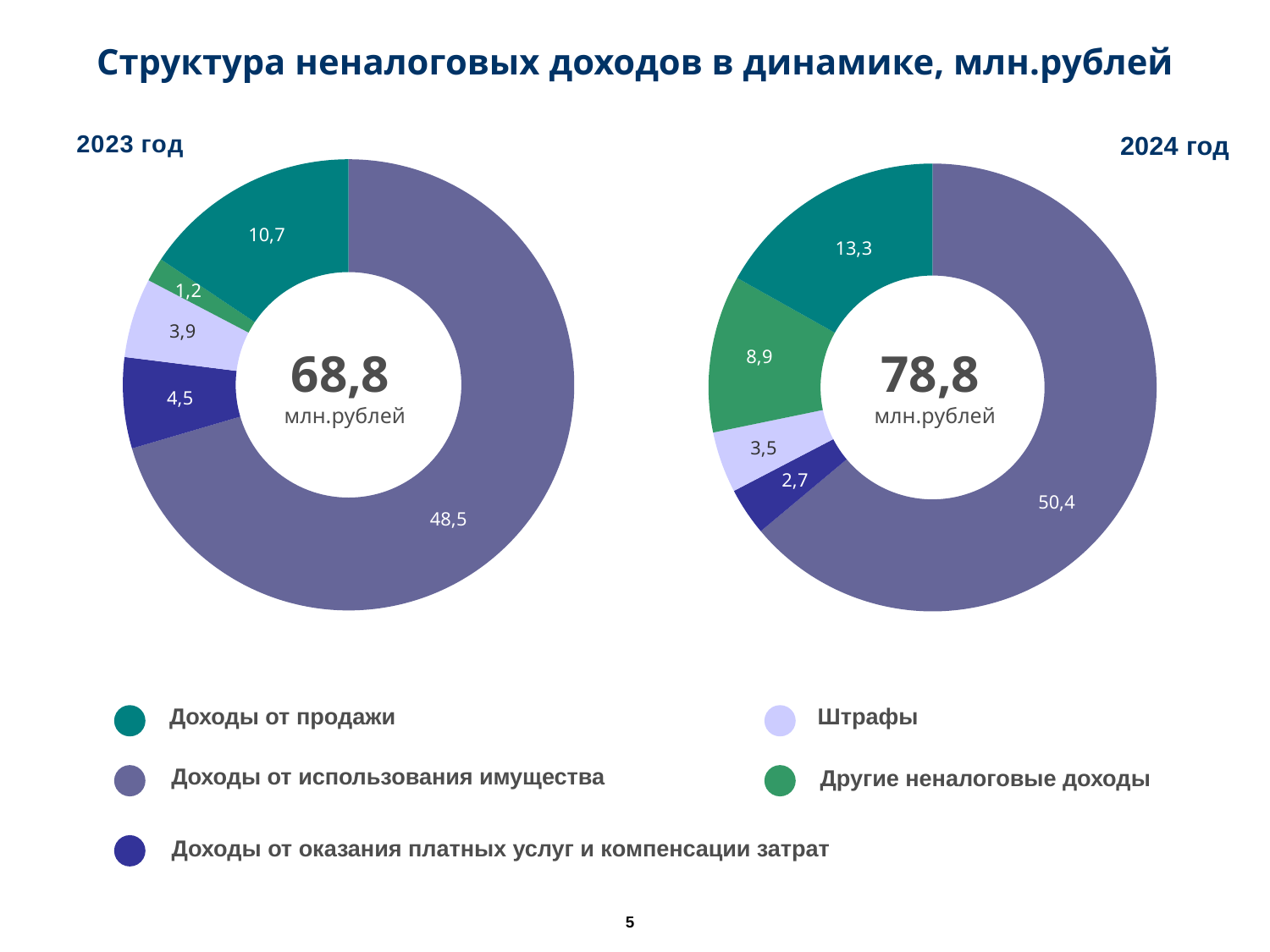
На диаграмме за 2024 год какая категория имеет наибольшее значение? Доходы от использования имущества Какого типа диаграммы представлены на слайде? Кольцевые (круговые) диаграммы Что больше: «Доходы от оказания платных услуг и компенсации затрат» в 2023 году или в 2024 году? 2023 год На диаграмме за 2023 год какое значение у категории «Доходы от использования имущества»? 48,5 Какой заголовок у слайда? Структура неналоговых доходов в динамике, млн.рублей На диаграмме за 2023 год какое значение у категории «Штрафы»? 3,9 На диаграмме за 2024 год какое значение у категории «Другие неналоговые доходы»? 8,9 Какая общая сумма указана в центре диаграммы за 2024 год? 78,8 млн.рублей На диаграмме за 2024 год какое значение у категории «Доходы от продажи»? 13,3 На диаграмме за 2023 год какая категория имеет наименьшее значение? Другие неналоговые доходы Сколько категорий показано на диаграмме за 2023 год? 5 На сколько значение «Доходы от использования имущества» в 2024 году больше, чем в 2023 году? 1,9